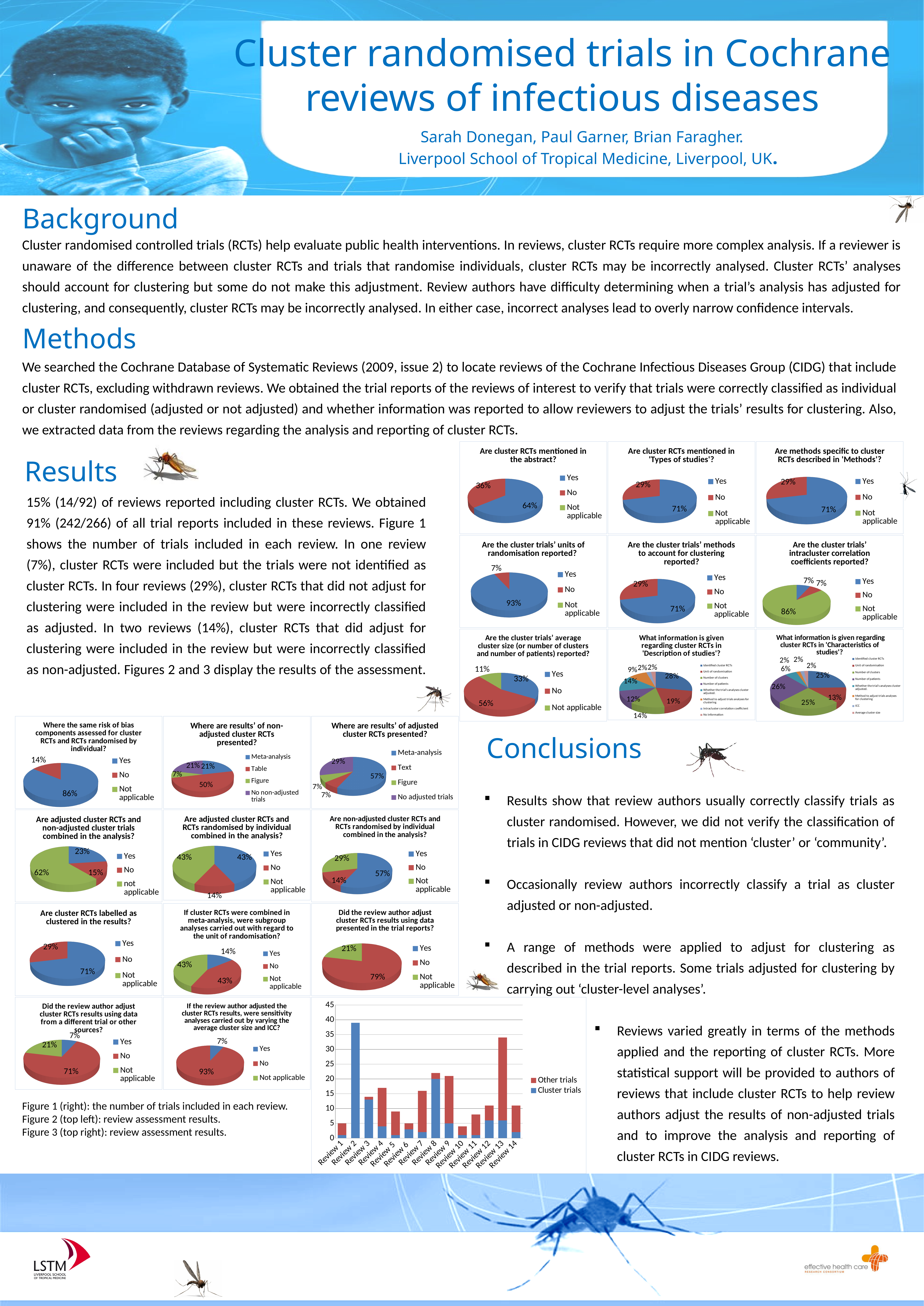
In the pie chart 'Where are results' of non-adjusted cluster RCTs presented?', what percentage is 'Table'? 50% What kind of chart is the chart at the bottom of the slide showing Review 1 to Review 14? Stacked bar chart In the bar chart at the bottom of the slide, is the total number of trials for Review 2 greater or less than 35? greater In the pie chart 'Are cluster RCTs mentioned in the abstract?', what percentage is 'Yes'? 64% In the pie chart 'Did the review author adjust cluster RCTs results using data presented in the trial reports?', which is larger, 'No' or 'Not applicable'? No In the pie chart 'Are the cluster trials' average cluster size (or number of clusters and number of patients) reported?', what percentage is 'No'? 56% How many reviews are shown on the x axis of the bar chart at the bottom of the slide? 14 How many series does the legend of the bar chart at the bottom of the slide list? 2 In the pie chart 'If the review author adjusted the cluster RCTs results, were sensitivity analyses carried out by varying the average cluster size and ICC?', what percentage is 'No'? 93% In the pie chart 'Where are results' of adjusted cluster RCTs presented?', what is the difference between the 'Meta-analysis' and 'No adjusted trials' percentages? 28% In the pie chart 'Are the cluster trials' intracluster correlation coefficients reported?', which category has the largest slice? Not applicable In the pie chart 'Are the cluster trials' units of randomisation reported?', what share of the pie is 'No'? 7%